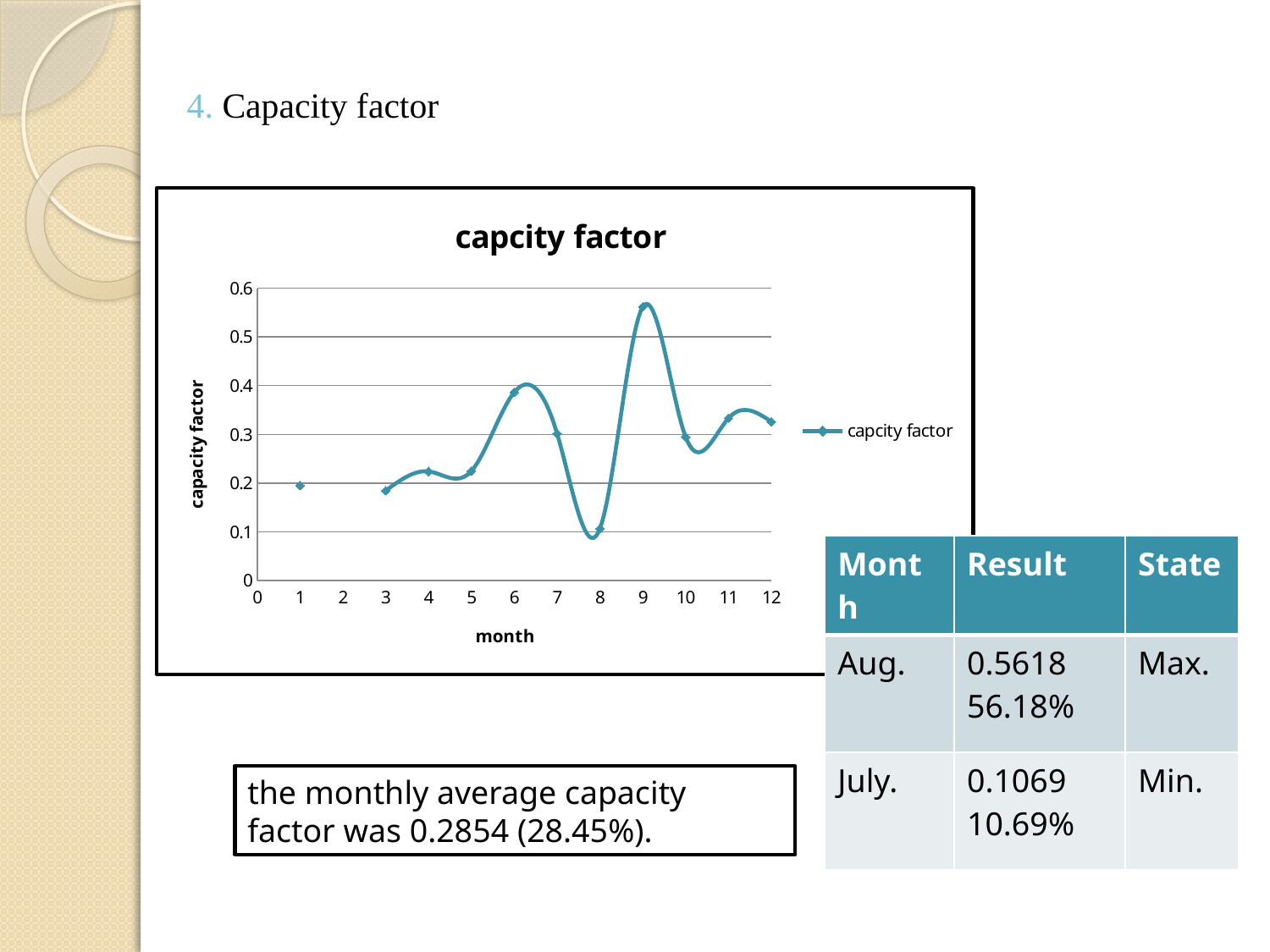
What kind of chart is shown on the slide? line chart Which has the larger capacity factor, month 6 or month 4? month 6 Is the capacity factor at month 8 greater or less than 0.2? less What is the label on the y axis of the chart? capacity factor Does the capacity factor rise or fall from month 7 to month 8? fall How many series does the chart legend list? 1 Is the capacity factor at month 9 greater or less than 0.5? greater Is the capacity factor at month 1 greater or less than 0.3? less At which month does the capacity factor reach its highest value? 9 At which month does the capacity factor reach its lowest value? 8 What is the title of the chart? capcity factor